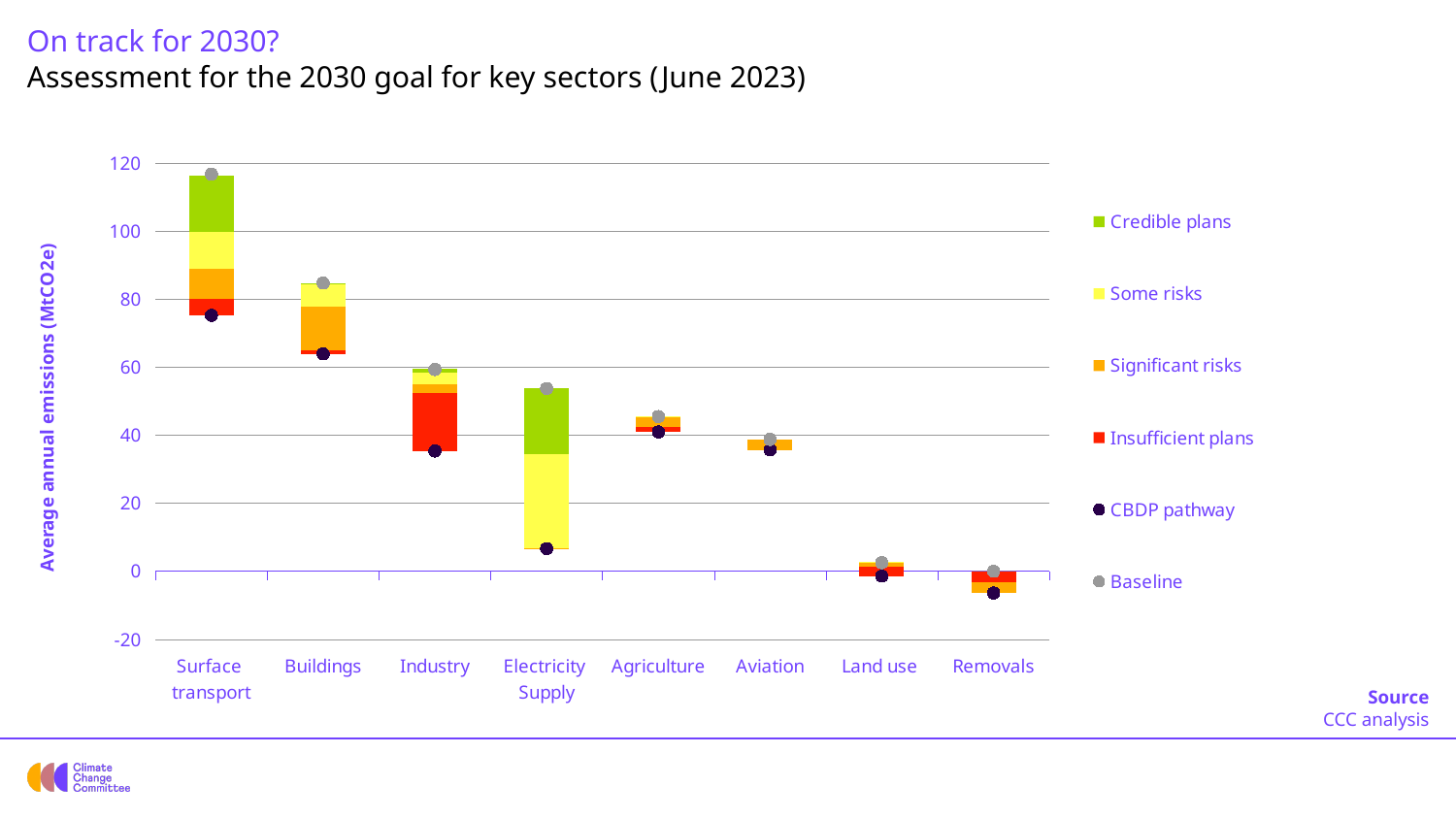
Which sector has the highest Baseline value? Surface transport Which has the larger Baseline value, Buildings or Industry? Buildings Is the Baseline value for Surface transport greater or less than 100? greater Which sector has the lowest CBDP pathway value? Removals What is the label on the vertical axis? Average annual emissions (MtCO2e) Do the Baseline values generally rise or fall from left to right across the sectors? fall Is the CBDP pathway value for Electricity Supply greater or less than 20? less Is the Baseline value for Buildings greater or less than 80? greater How many sectors are shown along the x axis? 8 What kind of chart is shown on the slide? Stacked bar chart with markers How many entries does the legend list? 6